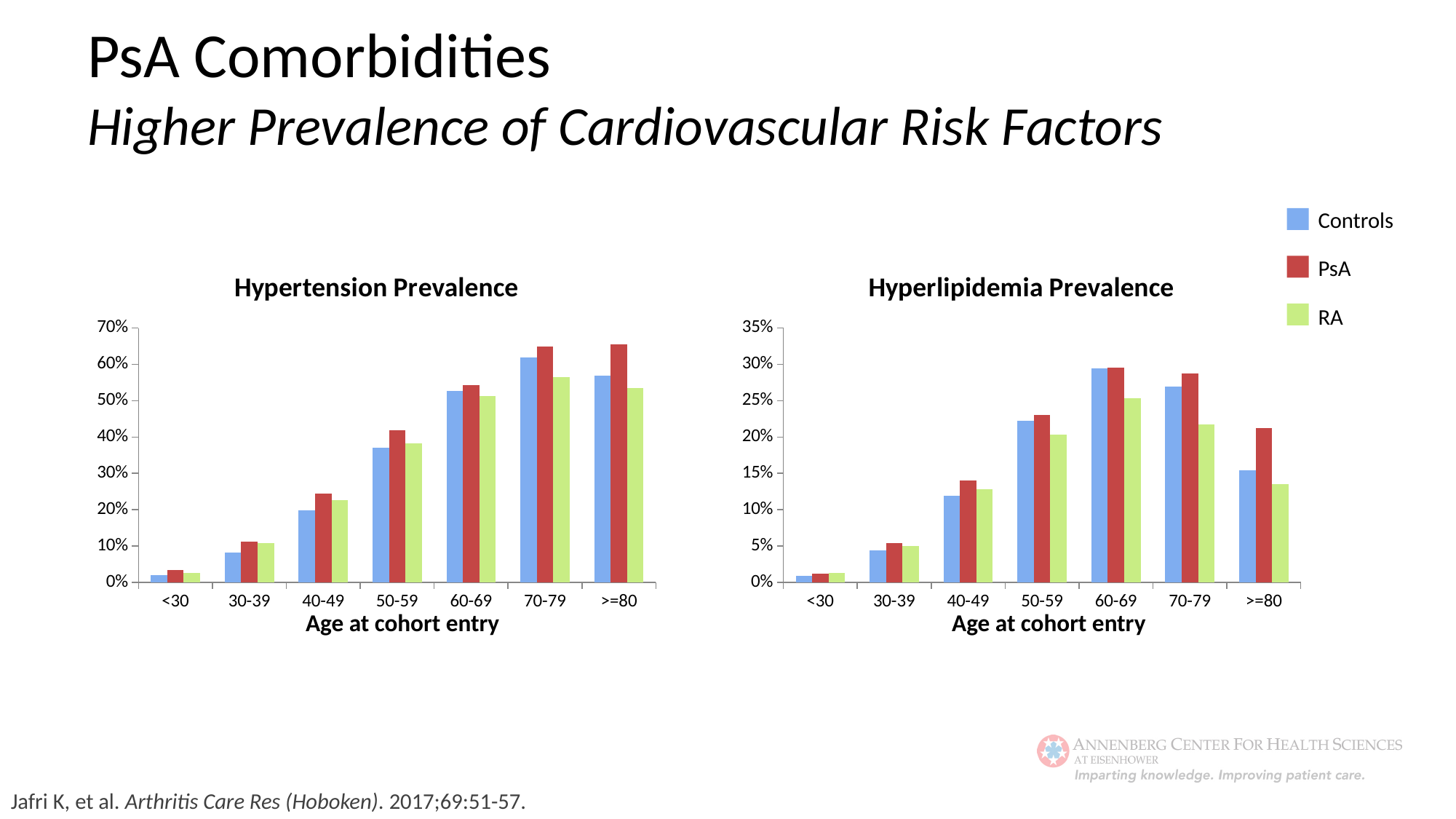
How many series does the legend list for the charts? 3 What is the x-axis title of the Hypertension Prevalence chart? Age at cohort entry What kind of chart is the Hypertension Prevalence chart? Bar chart In the Hyperlipidemia Prevalence chart, is the value for Controls in the >=80 age group greater or less than 20%? less In the Hyperlipidemia Prevalence chart, which age group has the highest value for RA? 60-69 In the Hypertension Prevalence chart, is the value for PsA in the 70-79 age group greater or less than 60%? greater How many age groups are shown on the x axis of the Hyperlipidemia Prevalence chart? 7 In the Hypertension Prevalence chart, which age group has the highest value for Controls? 70-79 In the Hyperlipidemia Prevalence chart, do the Controls values rise or fall from the 60-69 age group to the >=80 age group? fall In the Hypertension Prevalence chart, is the value for Controls in the 50-59 age group greater or less than 40%? less In the Hyperlipidemia Prevalence chart, which age group has the lowest value for Controls? <30 In the Hyperlipidemia Prevalence chart, which is larger in the >=80 age group, PsA or RA? PsA